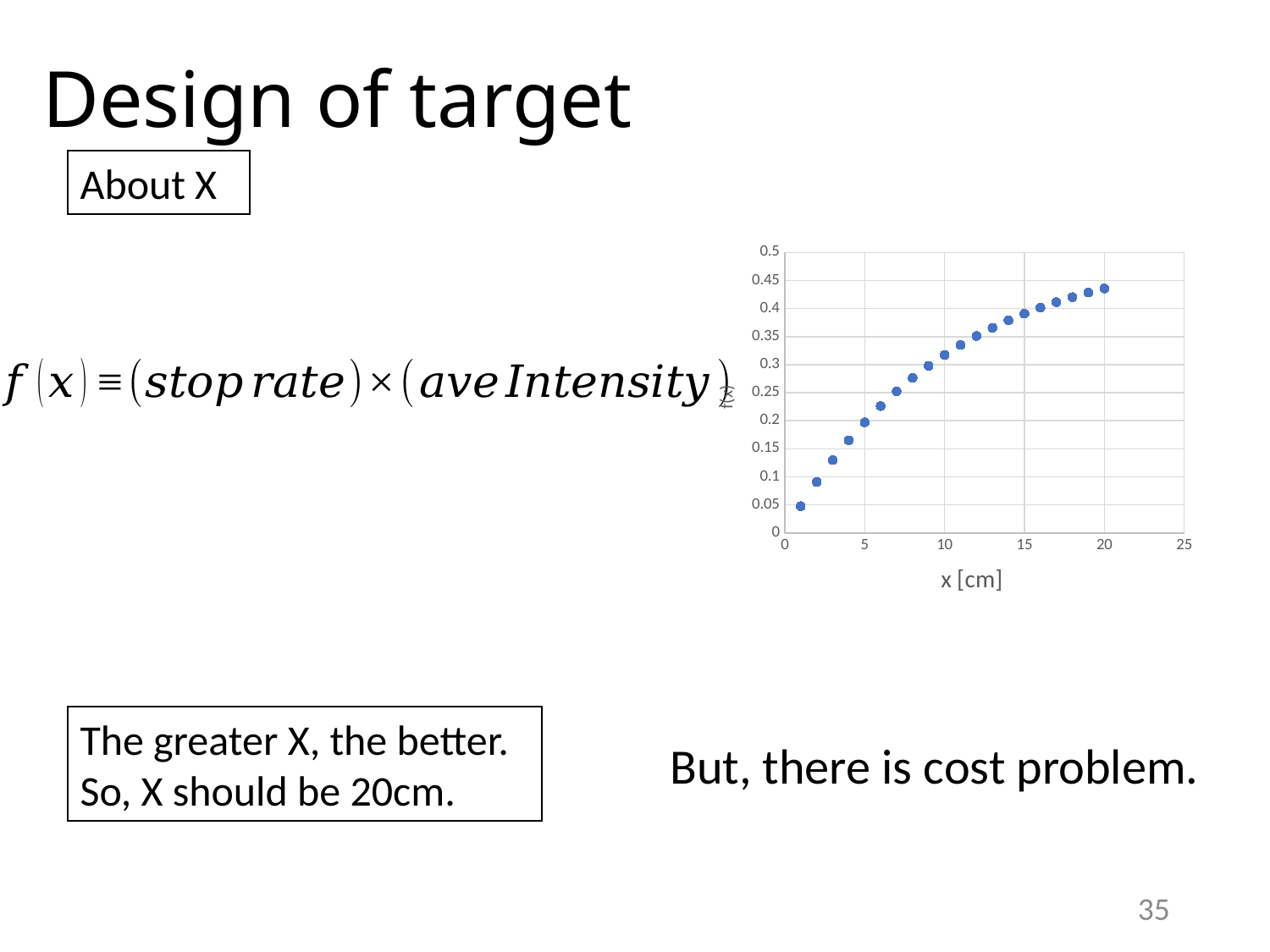
Is the value of f(x) at x = 1 greater or less than 0.1? less Is the value of f(x) at x = 20 greater or less than 0.4? greater Do the plotted values of f(x) rise or fall as x increases? rise Is the value of f(x) at x = 15 greater or less than 0.35? greater What kind of chart is shown on the slide? scatter chart At which x value is f(x) lowest? 1 Which is larger, f(x) at x = 5 or f(x) at x = 15? x = 15 What is the label of the horizontal axis of the chart? x [cm] At which x value is f(x) highest? 20 What is the maximum value shown on the vertical axis of the chart? 0.5 How many data points are plotted in the chart? 20